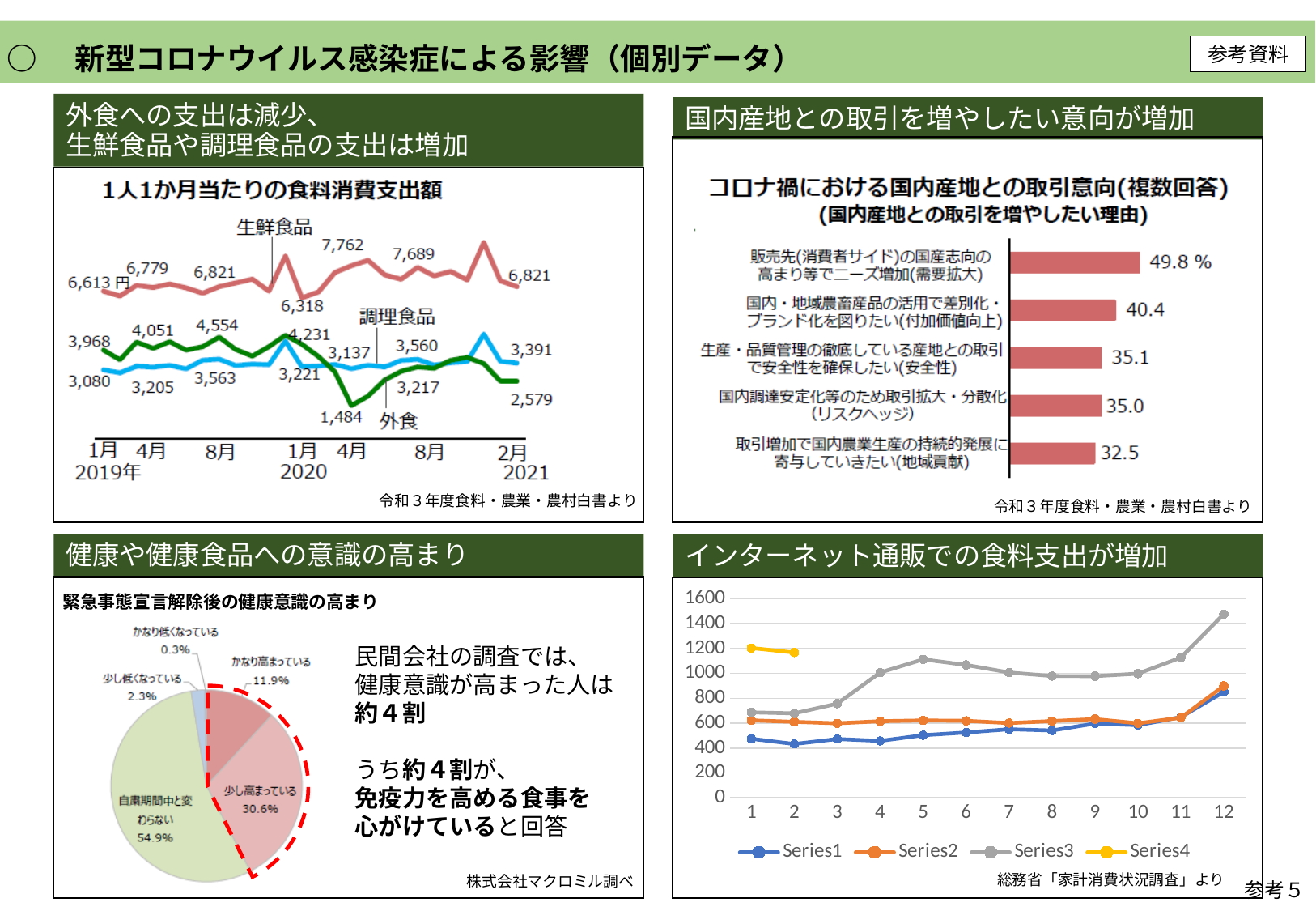
In the bottom-left pie chart (緊急事態宣言解除後の健康意識の高まり), what share is 自粛期間中と変わらない? 54.9% In the bottom-right line chart (インターネット通販での食料支出が増加), is the value for Series3 at point 12 greater or less than 1400? greater In the top-left line chart (1人1か月当たりの食料消費支出額), what is the highest labelled value for 生鮮食品? 7,762 In the top-right bar chart (コロナ禍における国内産地との取引意向), what is the difference between the values for 需要拡大 (49.8) and 付加価値向上 (40.4)? 9.4 In the top-left line chart (1人1か月当たりの食料消費支出額), what is the value for 調理食品 at 2月 2021? 3,391 In the top-left line chart (1人1か月当たりの食料消費支出額), how many series are plotted? 3 In the bottom-left pie chart (緊急事態宣言解除後の健康意識の高まり), which slice is the smallest? かなり低くなっている In the top-left line chart (1人1か月当たりの食料消費支出額), what is the lowest labelled value for 外食? 1,484 In the top-right bar chart (コロナ禍における国内産地との取引意向), what is the value for 販売先(消費者サイド)の国産志向の高まり等でニーズ増加(需要拡大)? 49.8% In the top-right bar chart (コロナ禍における国内産地との取引意向), how many bars are shown? 5 In the bottom-right line chart (インターネット通販での食料支出が増加), how many series does the legend list? 4 In the top-right bar chart (コロナ禍における国内産地との取引意向), which reason has the lowest value? 取引増加で国内農業生産の持続的発展に寄与していきたい(地域貢献)